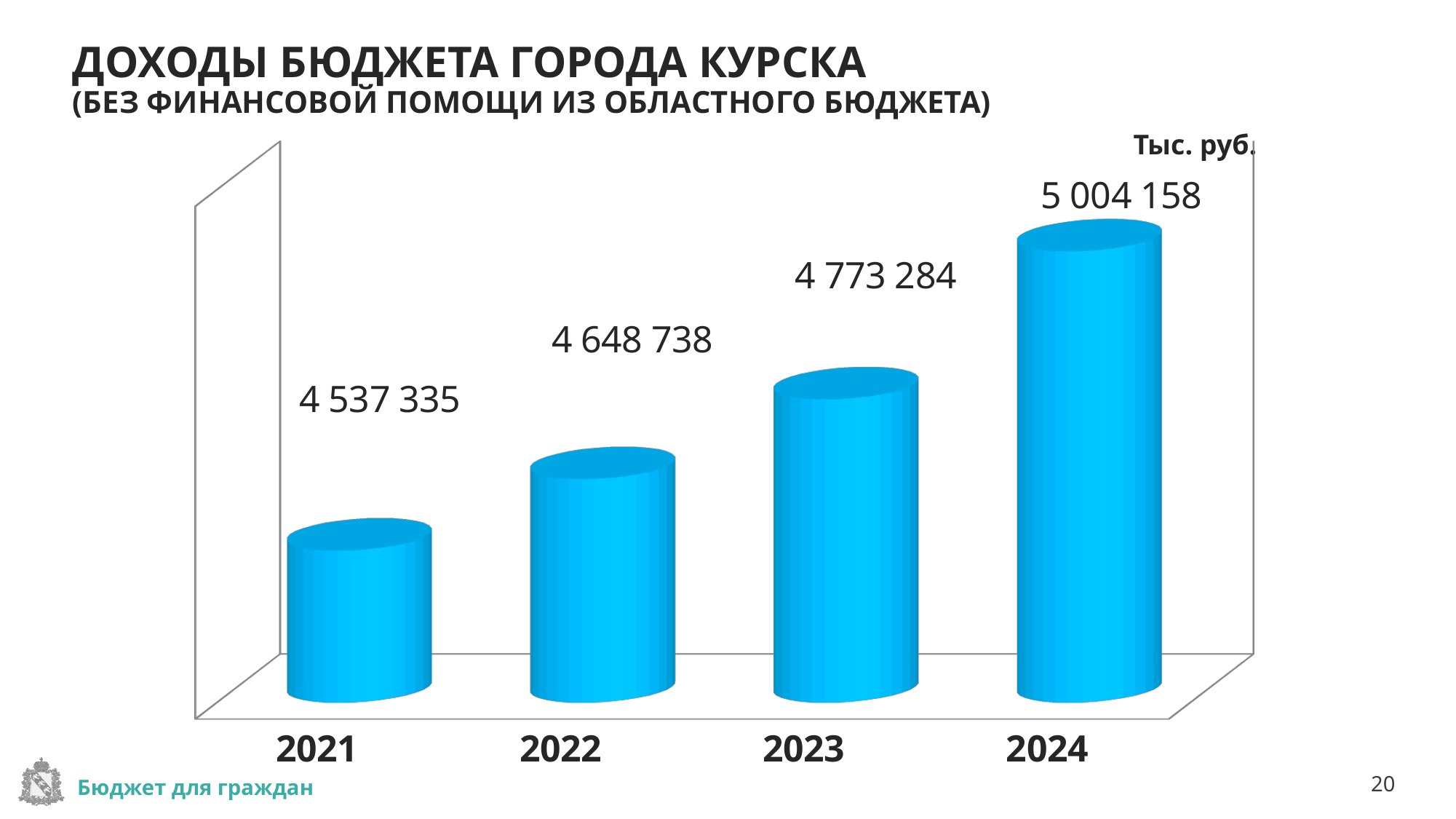
How many years are shown on the chart? 4 What is the difference between the values for 2024 and 2023? 230 874 Which is larger, the value for 2022 or the value for 2023? 2023 Which year has the highest value? 2024 What is the value for 2022? 4 648 738 Which year has the lowest value? 2021 What is the value for 2024? 5 004 158 What is the value for 2021? 4 537 335 What kind of chart is shown on the slide? bar chart Do the values rise or fall from 2021 to 2024? rise What is the difference between the values for 2024 and 2021? 466 823 What is the value for 2023? 4 773 284